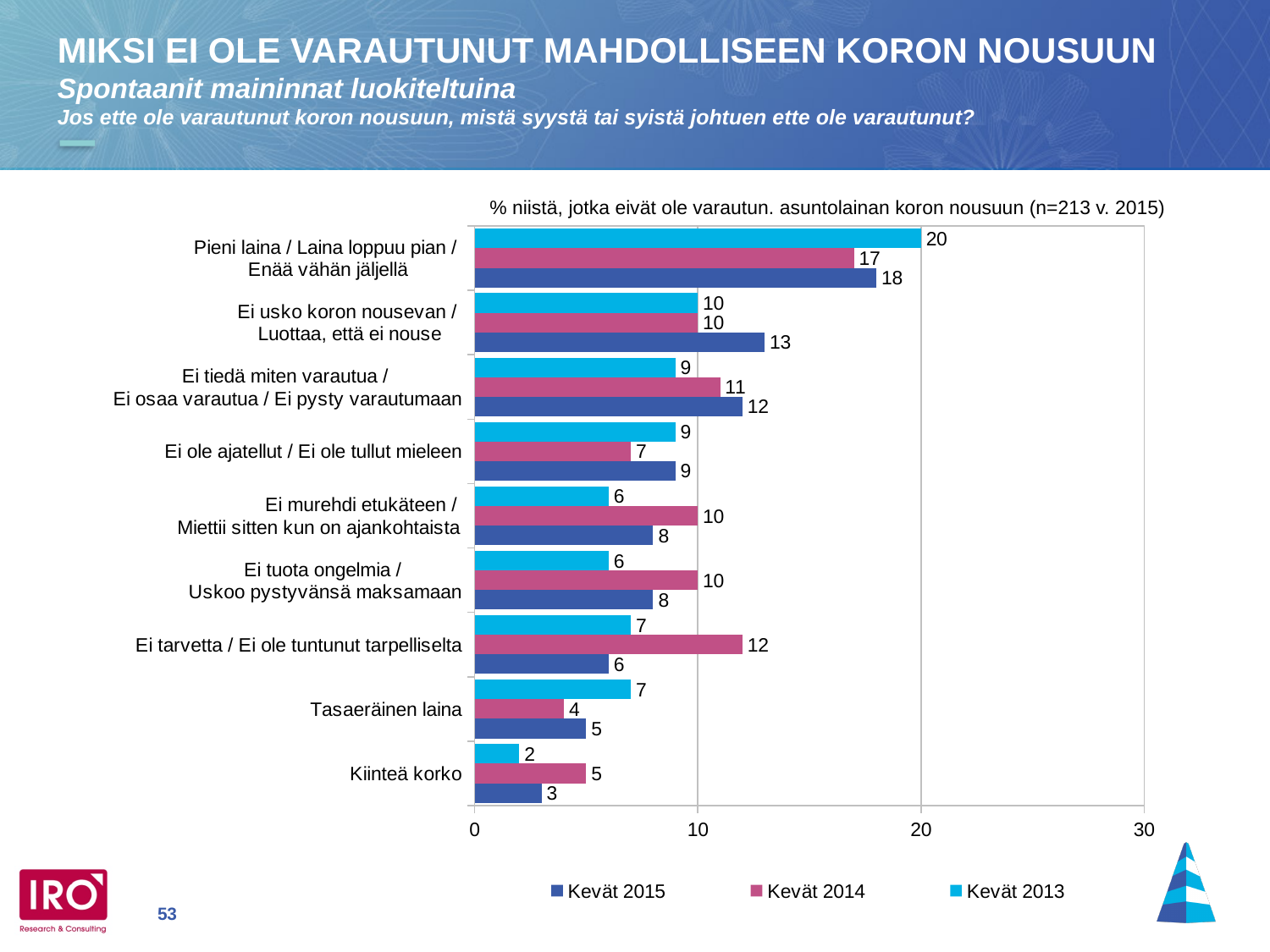
What kind of chart is shown on the slide? bar chart What is the difference between the Kevät 2015 and Kevät 2014 values for "Ei usko koron nousevan / Luottaa, että ei nouse"? 3 How many series does the legend list? 3 Which category has the lowest value in the Kevät 2013 series? Kiinteä korko Which category has the highest value in the Kevät 2015 series? Pieni laina / Laina loppuu pian / Enää vähän jäljellä How many categories are shown on the chart? 9 What is the value for "Ei tarvetta / Ei ole tuntunut tarpelliselta" in the Kevät 2014 series? 12 Is the Kevät 2013 value for "Pieni laina / Laina loppuu pian / Enää vähän jäljellä" greater or less than 10? greater What is the sample size (n) stated in the chart's subtitle for 2015? 213 What is the value for "Pieni laina / Laina loppuu pian / Enää vähän jäljellä" in the Kevät 2015 series? 18 For "Tasaeräinen laina", which series has the larger value, Kevät 2013 or Kevät 2014? Kevät 2013 What is the value for "Kiinteä korko" in the Kevät 2013 series? 2